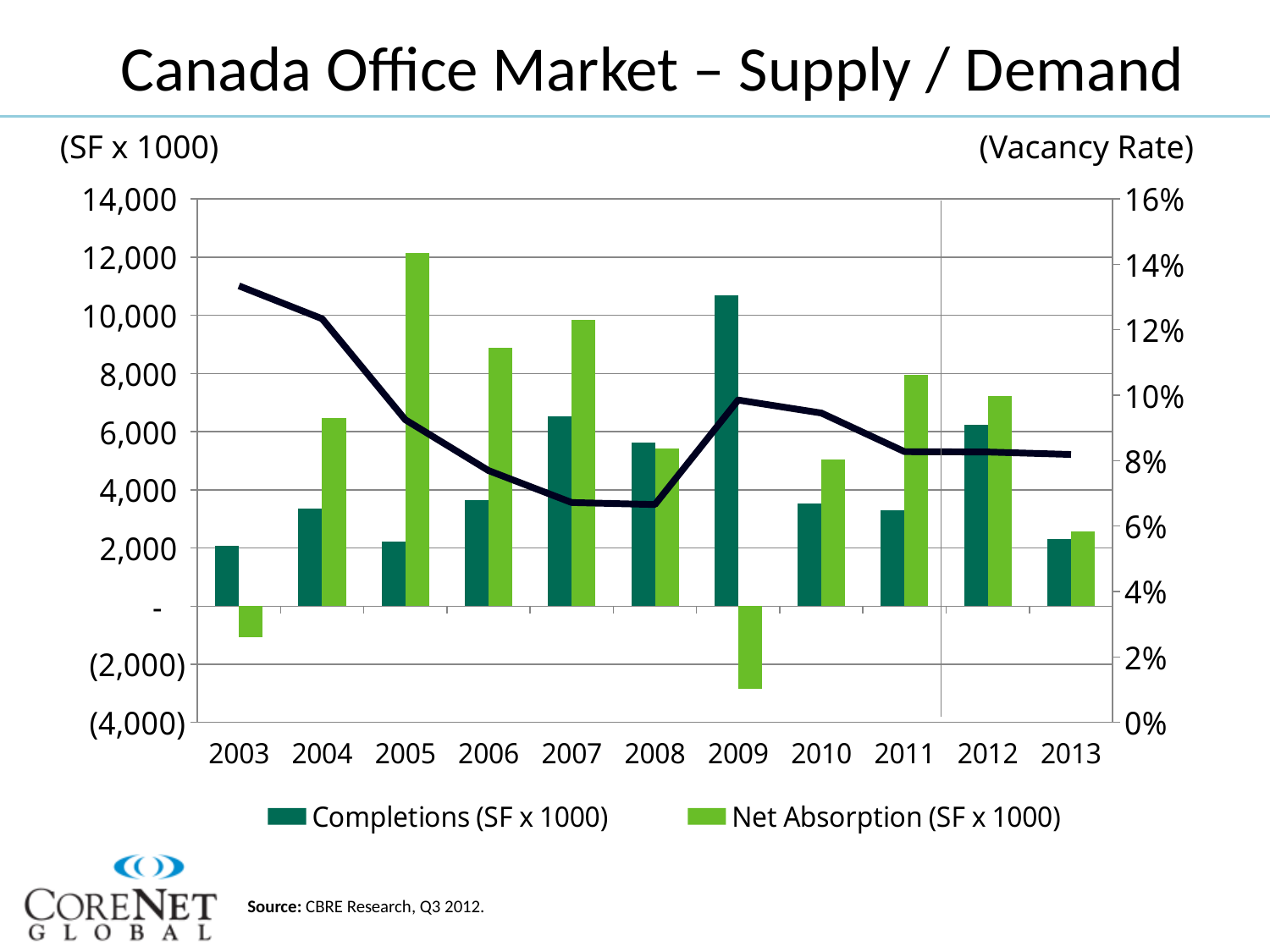
What is the source cited for the chart? CBRE Research, Q3 2012. In 2007, which is larger: Completions or Net Absorption? Net Absorption What kind of chart is shown on the slide? bar chart with a line Is the value for Net Absorption in 2011 greater or less than 6,000? greater In which year is Net Absorption (SF x 1000) highest? 2005 Does the vacancy rate line rise or fall from 2003 to 2008? fall Is the value for Completions in 2009 greater or less than 10,000? greater How many years are shown on the x axis of the chart? 11 In which year is Net Absorption (SF x 1000) lowest? 2009 How many series does the legend list? 2 Is the vacancy rate in 2008 greater or less than 8%? less In which year is Completions (SF x 1000) highest? 2009